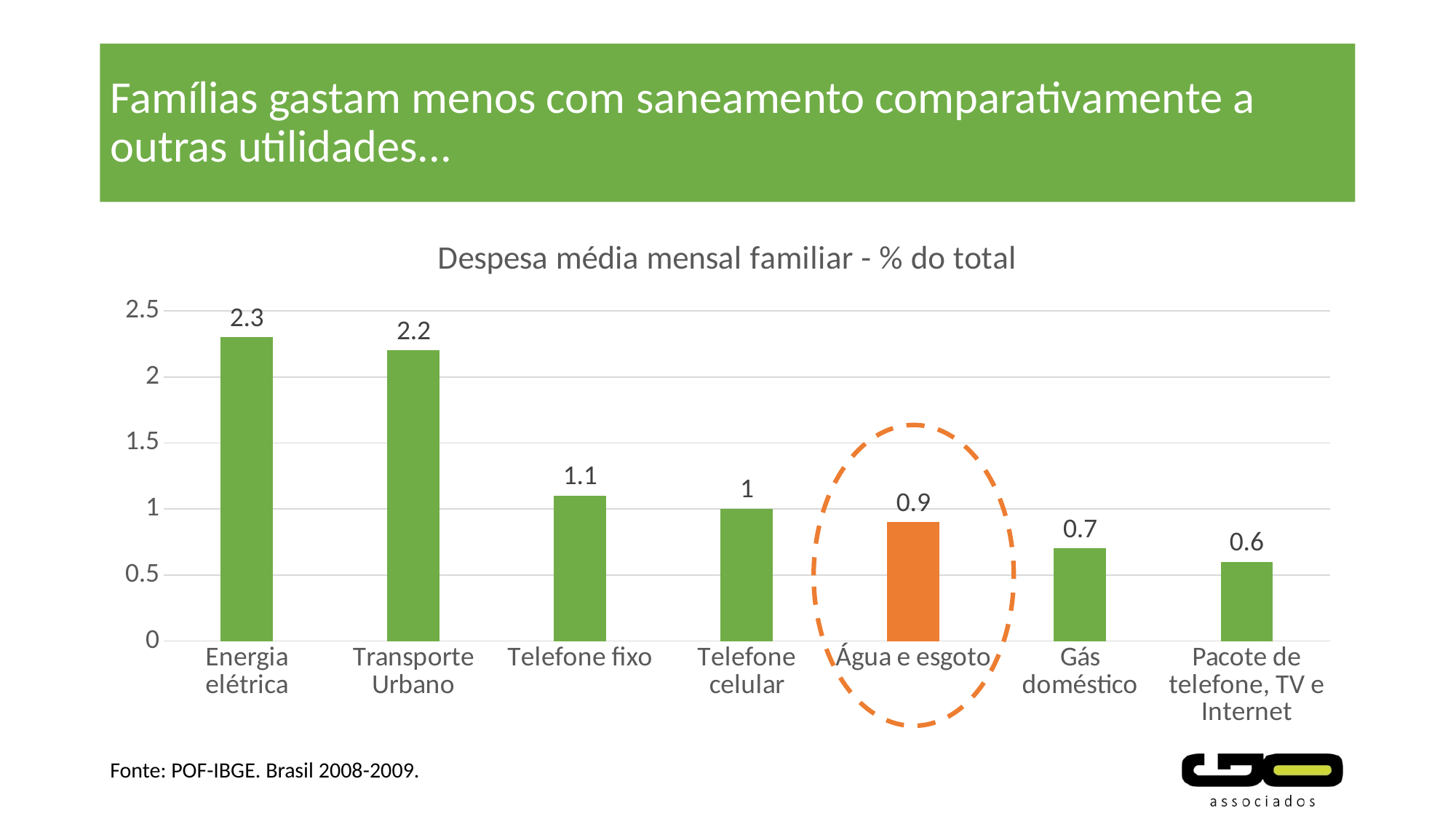
What is the difference between the values for Transporte Urbano and Gás doméstico? 1.5 Which category has the lowest value? Pacote de telefone, TV e Internet Is the value for Transporte Urbano greater or less than 2? greater Which category has the highest value? Energia elétrica Which is larger, the value for Telefone fixo or the value for Telefone celular? Telefone fixo What is the value for Água e esgoto? 0.9 What is the value for Pacote de telefone, TV e Internet? 0.6 What kind of chart is shown on the slide? Bar chart How many categories are shown in the chart? 7 What is the value for Energia elétrica? 2.3 What is the title of the chart? Despesa média mensal familiar - % do total Do the values rise or fall from left to right along the x axis? Fall